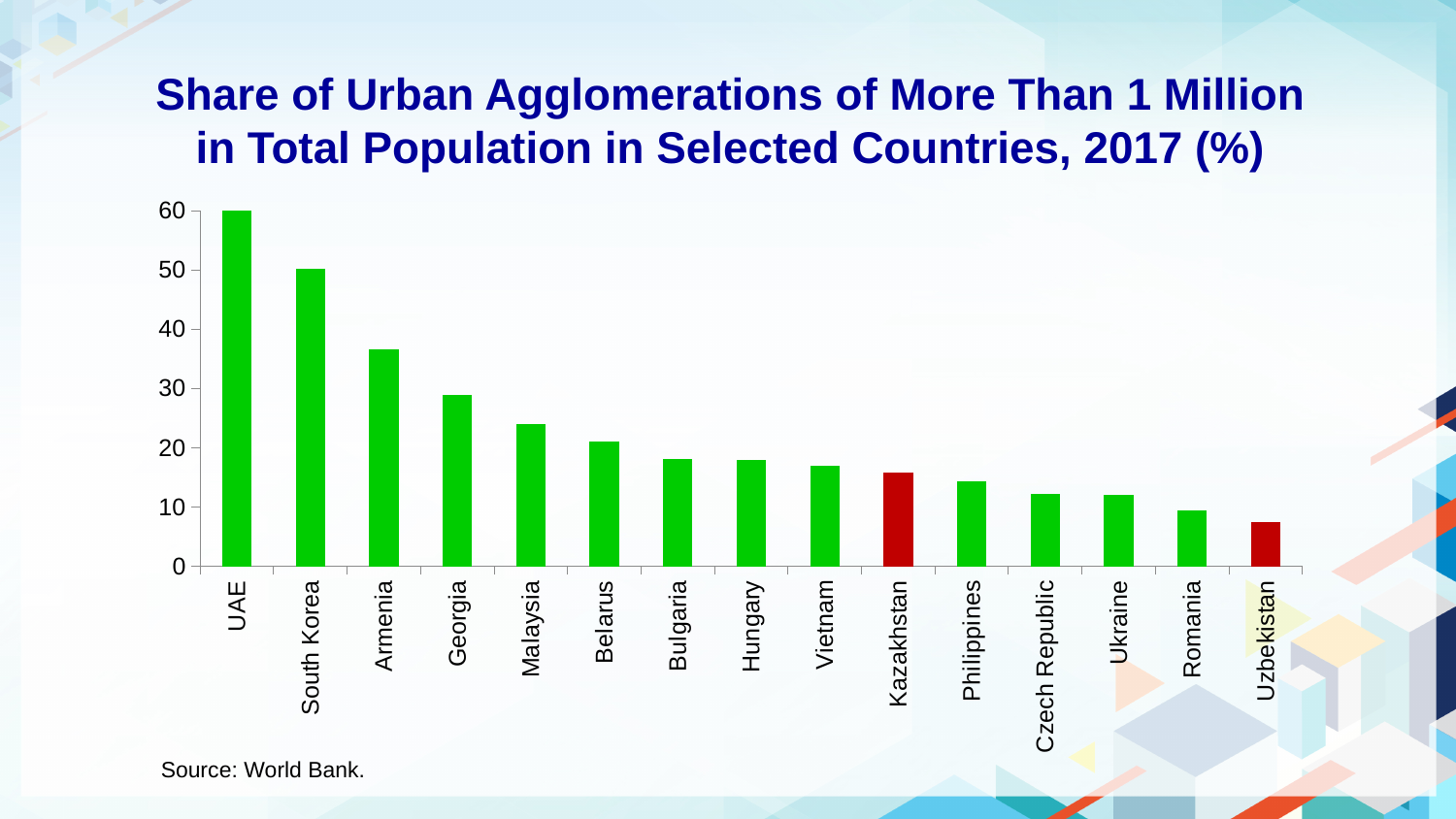
Is the value for Georgia greater or less than 30? less What kind of chart is shown on the slide? bar chart What source is cited for the chart data? World Bank How many countries are shown in the chart? 15 Which country has the lowest share in the chart? Uzbekistan Do the values rise or fall moving from left to right along the x axis? fall Which has a larger share, South Korea or Malaysia? South Korea Which has a larger share, Armenia or Georgia? Armenia Which two countries are shown with red bars instead of green? Kazakhstan and Uzbekistan Is the value for Malaysia greater or less than 20? greater Is the value for Romania greater or less than 10? less Which country has the highest share of urban agglomerations of more than 1 million in total population? UAE